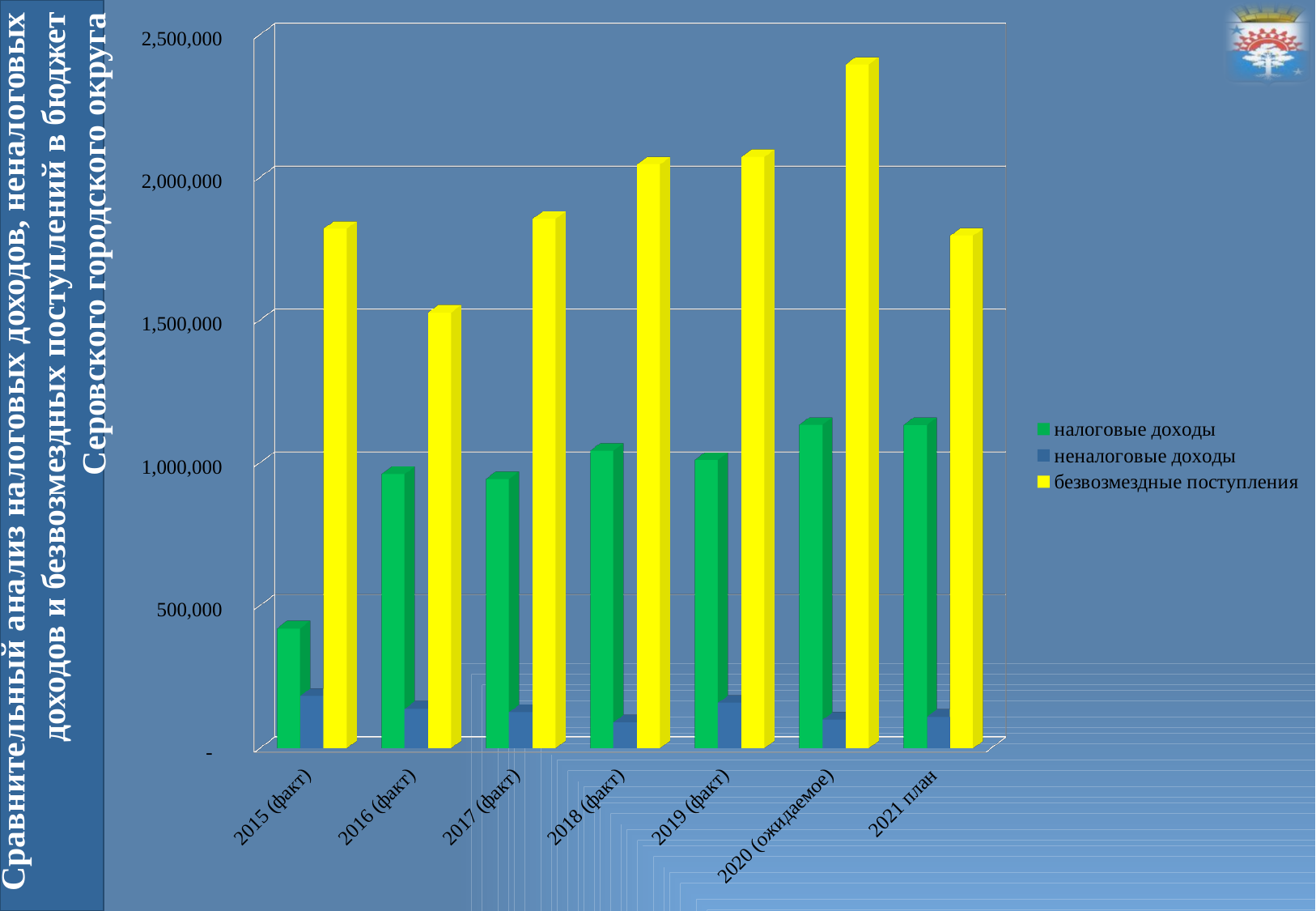
Is the value for налоговые доходы in 2015 (факт) greater or less than 500,000? less What kind of chart is shown on the slide? bar chart Which colour represents неналоговые доходы in the legend? blue Which series has the larger value in 2015 (факт): налоговые доходы or безвозмездные поступления? безвозмездные поступления How many categories (years) are shown on the x axis? 7 Is the value for безвозмездные поступления in 2020 (ожидаемое) greater or less than 2,000,000? greater Which is larger: налоговые доходы in 2015 (факт) or in 2016 (факт)? 2016 (факт) How many series does the legend list? 3 Is the value for безвозмездные поступления in 2021 план greater or less than 2,000,000? less In which category is the value for налоговые доходы the lowest? 2015 (факт) In which category is the value for безвозмездные поступления the highest? 2020 (ожидаемое) In which category is the value for безвозмездные поступления the lowest? 2016 (факт)